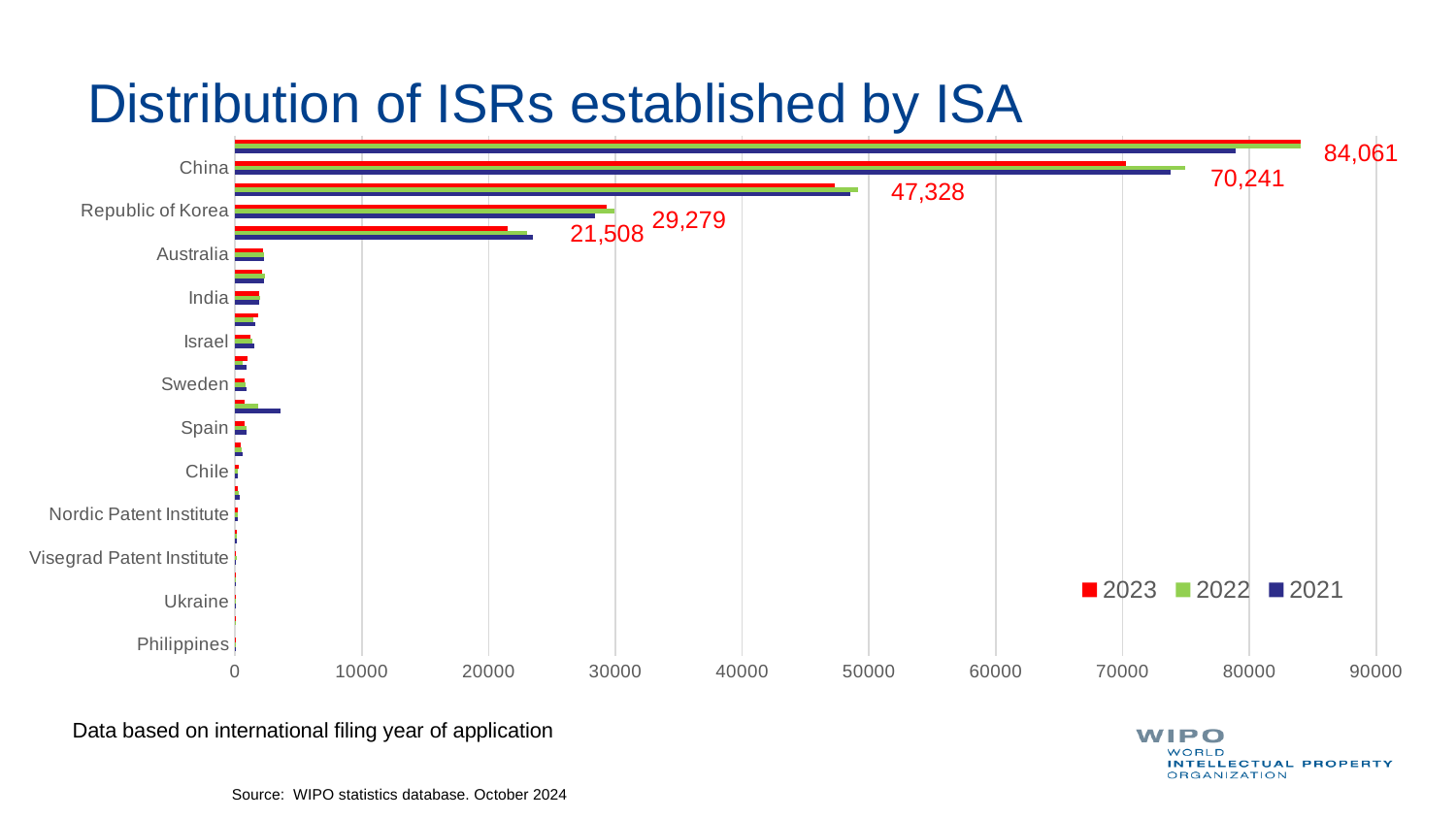
Which has the larger 2021 value, Republic of Korea or Israel? Republic of Korea Among the labelled ISAs, which has the highest values? China What is the 2023 value for Republic of Korea? 29,279 What is the title of the chart? Distribution of ISRs established by ISA What is the difference between the 2023 values for China and Republic of Korea? 40,962 Is the 2022 value for Australia greater or less than 10000? less What is the 2023 value for China? 70,241 What kind of chart is shown on the slide? bar chart Which has the larger 2023 value, China or Republic of Korea? China How many series does the legend list? 3 Is the 2023 value for China greater or less than 60000? greater Which years are listed in the legend? 2023, 2022, 2021